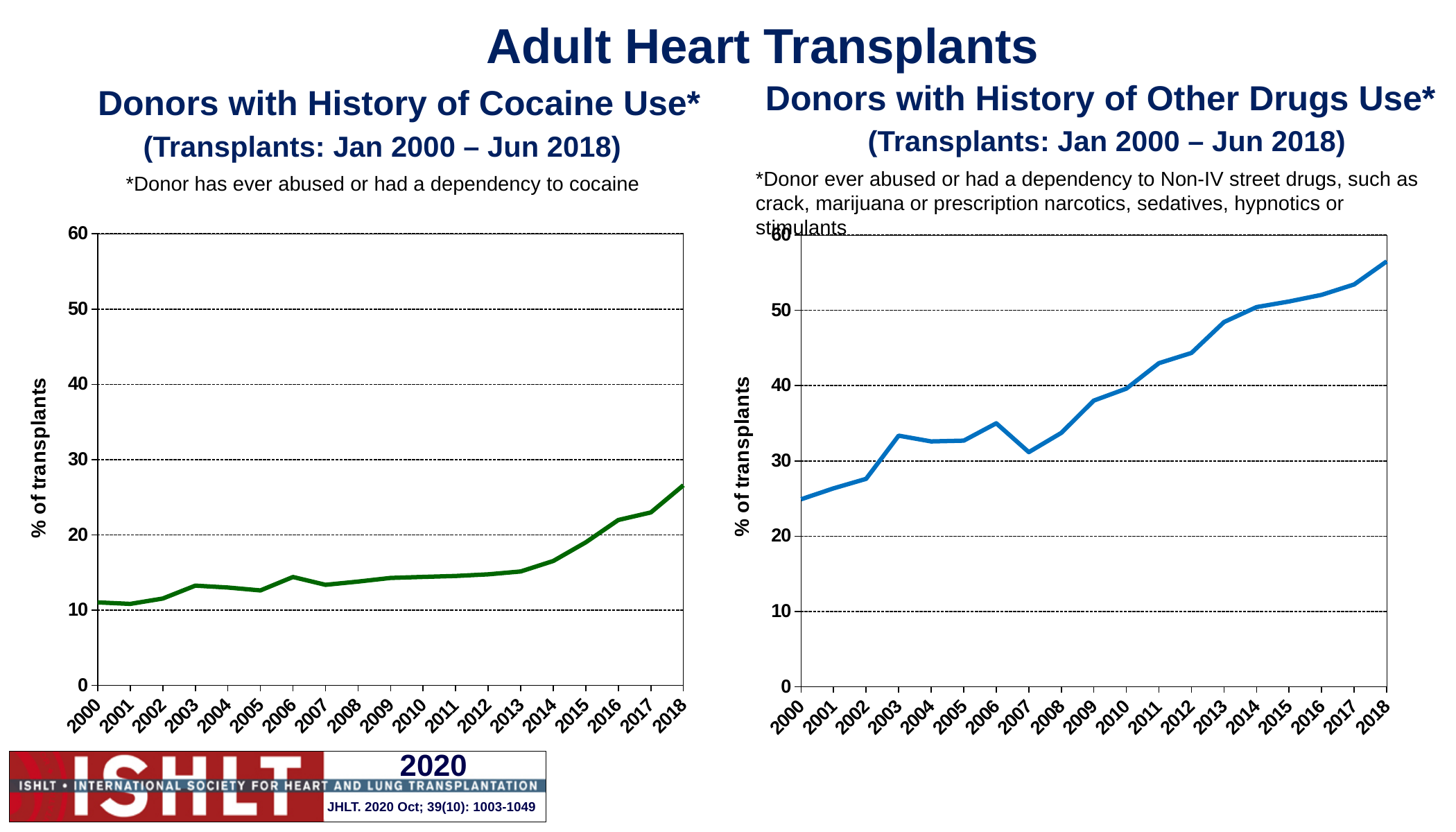
In the 'Donors with History of Cocaine Use' chart, is the value for 2018 greater or less than 20? greater In the 'Donors with History of Cocaine Use' chart, is the value for 2000 greater or less than 20? less In the 'Donors with History of Other Drugs Use' chart, which year has the highest value? 2018 How many years are plotted on the x axis of the 'Donors with History of Other Drugs Use' chart? 19 In the 'Donors with History of Cocaine Use' chart, which year has the highest value? 2018 In the 'Donors with History of Other Drugs Use' chart, is the value for 2018 greater or less than 50? greater What is the y-axis label of the 'Donors with History of Cocaine Use' chart? % of transplants In the 'Donors with History of Other Drugs Use' chart, which year has the lowest value? 2000 What kind of chart is the 'Donors with History of Cocaine Use' chart? line chart Overall, do the values in the 'Donors with History of Other Drugs Use' chart rise or fall from 2000 to 2018? rise